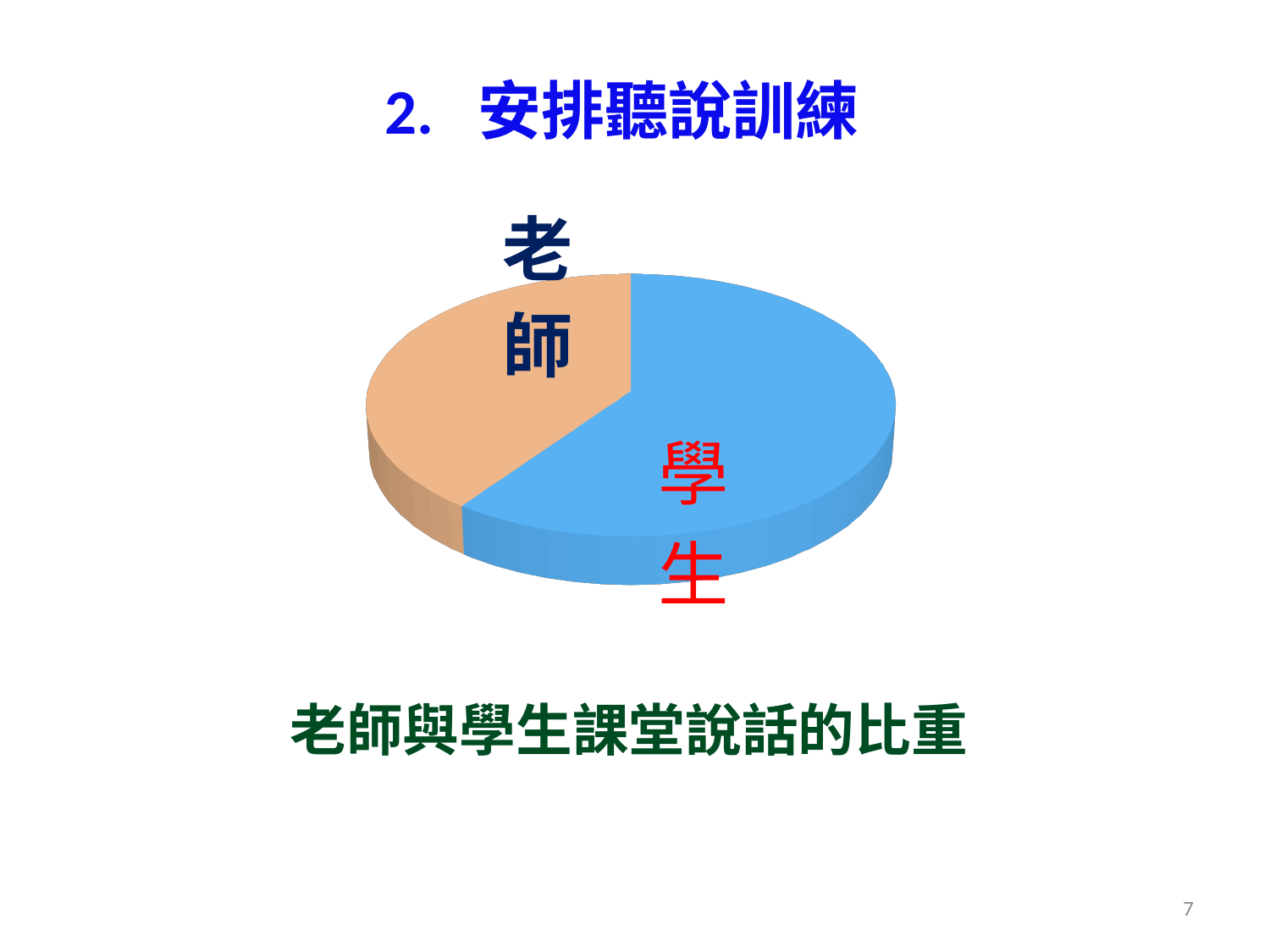
Does the 老師 slice take up more or less than half of the pie? less What kind of chart is shown on the slide? pie chart Does the 學生 slice take up more or less than half of the pie? more What colour is the 學生 slice of the pie chart? blue Which slice of the pie chart is the smallest? 老師 Which slice of the pie chart is the largest? 學生 Which slice is larger, 老師 or 學生? 學生 What caption appears below the pie chart? 老師與學生課堂說話的比重 How many slices does the pie chart have? 2